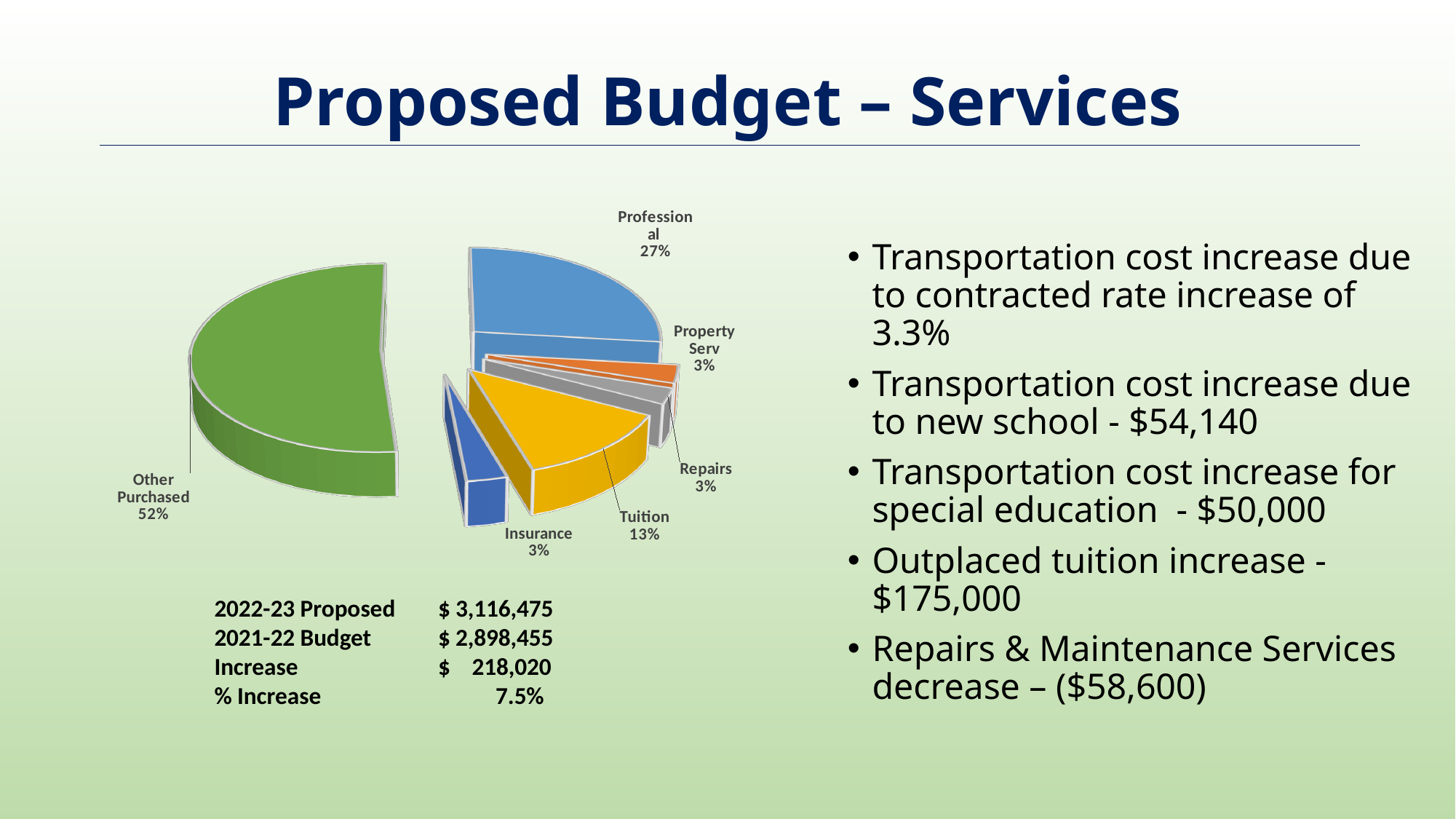
What share of the pie does Professional represent? 27% What kind of chart is shown on the slide? Pie chart What is the difference in percentage points between Other Purchased and Professional? 25 What share of the pie does Insurance represent? 3% What share of the pie does Property Serv represent? 3% How many slices does the pie chart have? 6 Which category has the largest slice of the pie? Other Purchased What is the difference in percentage points between Professional and Tuition? 14 Which is larger, the Tuition slice or the Repairs slice? Tuition What colour is the Other Purchased slice? Green